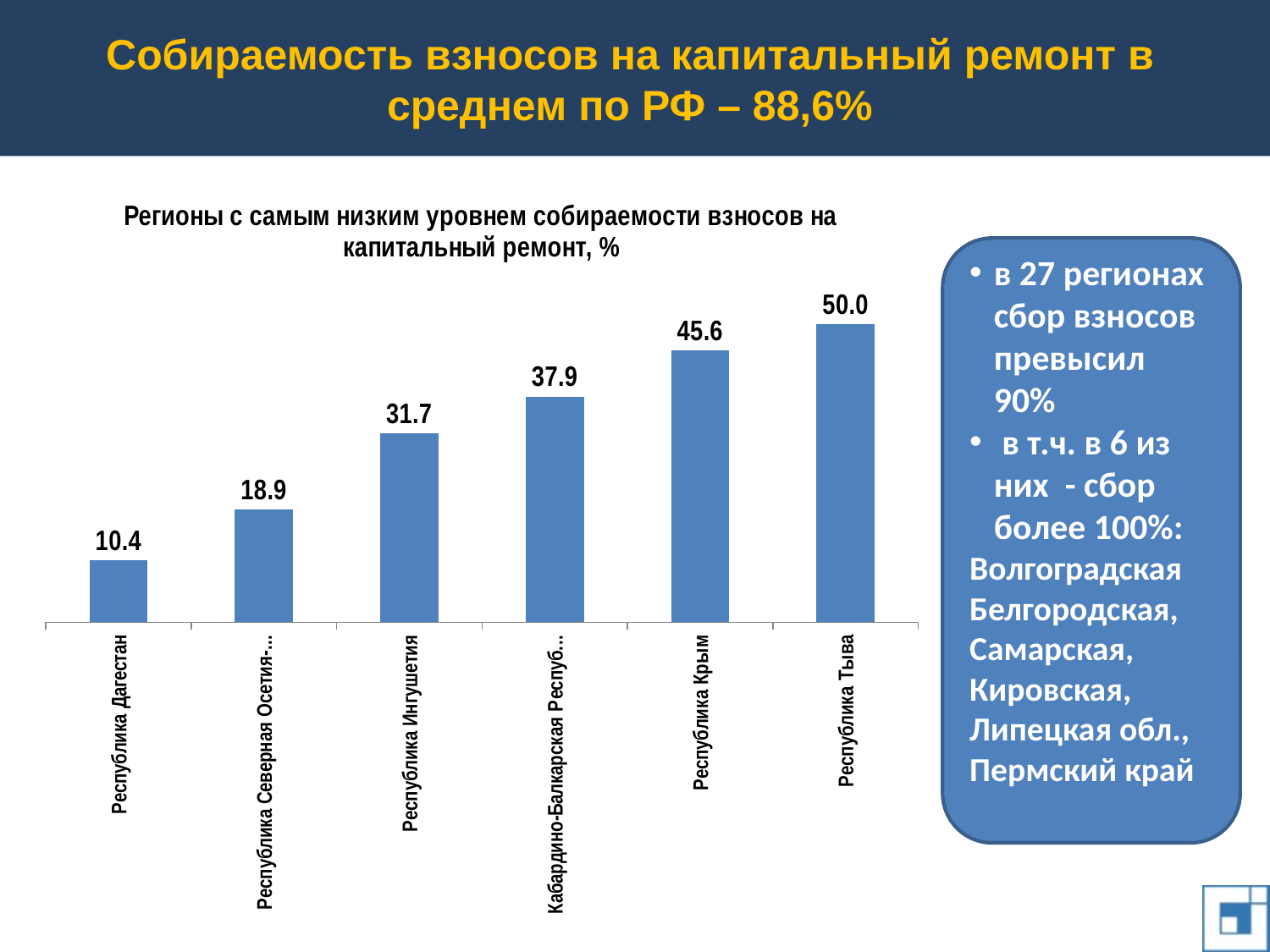
Which is larger, the value for Республика Северная Осетия or the value for Республика Ингушетия? Республика Ингушетия What is the value for Республика Дагестан? 10.4 Which region has the lowest value on the chart? Республика Дагестан What is the value for Республика Ингушетия? 31.7 What kind of chart is shown on the slide? Bar chart What is the value for Республика Тыва? 50.0 What is the difference between the values for Республика Крым and Кабардино-Балкарская Республика? 7.7 What is the difference between the values for Республика Тыва and Республика Дагестан? 39.6 Which region has the highest value on the chart? Республика Тыва How many regions are shown on the chart? 6 Do the values rise or fall from left to right across the chart? Rise What is the value for Республика Крым? 45.6